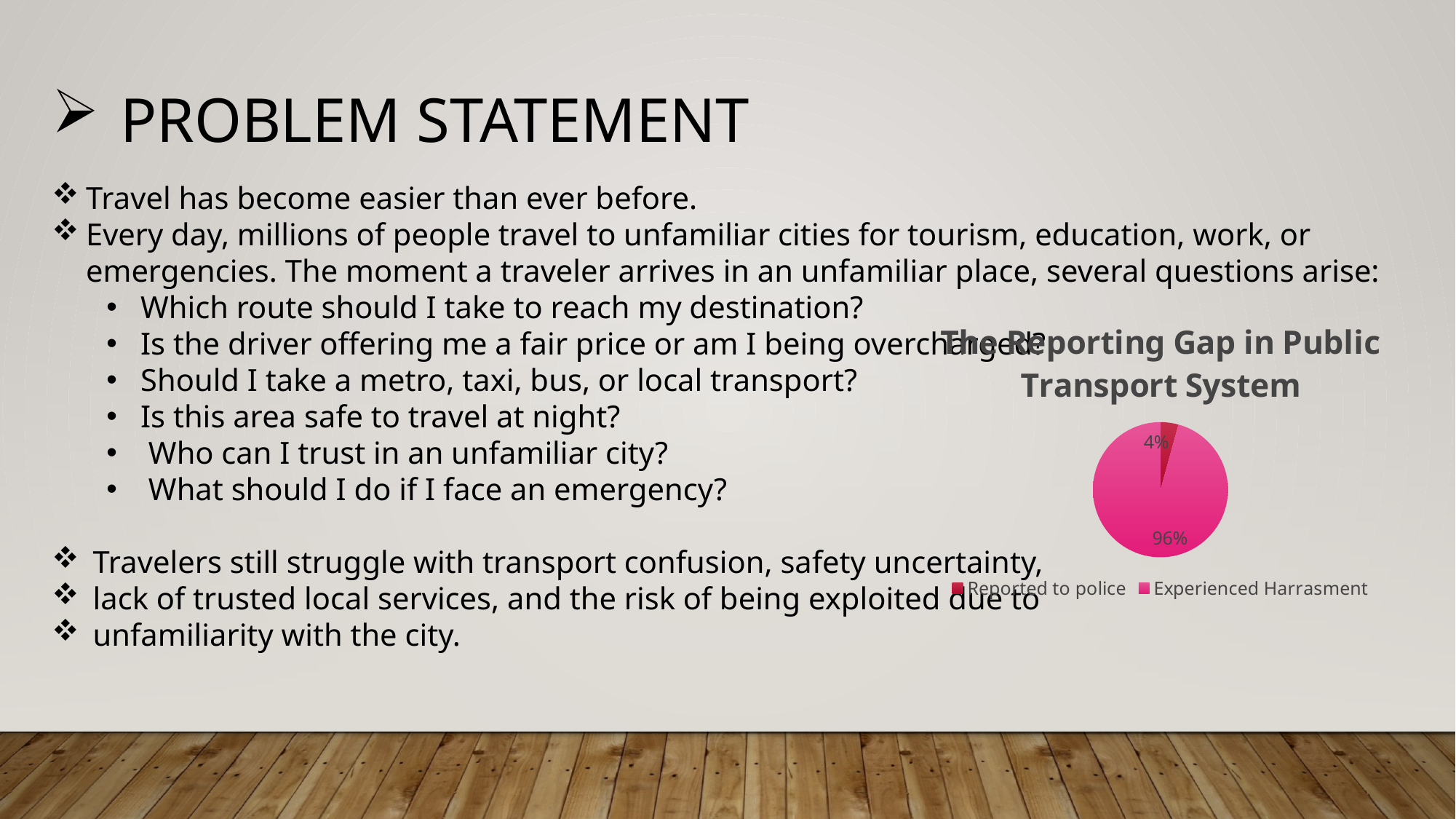
What share of the pie is labelled "Experienced Harrasment"? 96% How many slices does the pie chart have? 2 Which slice of the pie is the largest? Experienced Harrasment What is the title of the chart? The Reporting Gap in Public Transport System Which is larger, the "Reported to police" slice or the "Experienced Harrasment" slice? Experienced Harrasment Which slice of the pie is the smallest? Reported to police What share of the pie is labelled "Reported to police"? 4% How many entries does the legend list? 2 What kind of chart is shown on the slide? pie chart What is the difference in percentage points between the "Experienced Harrasment" slice and the "Reported to police" slice? 92 Which legend entry is shown in the darker red colour? Reported to police